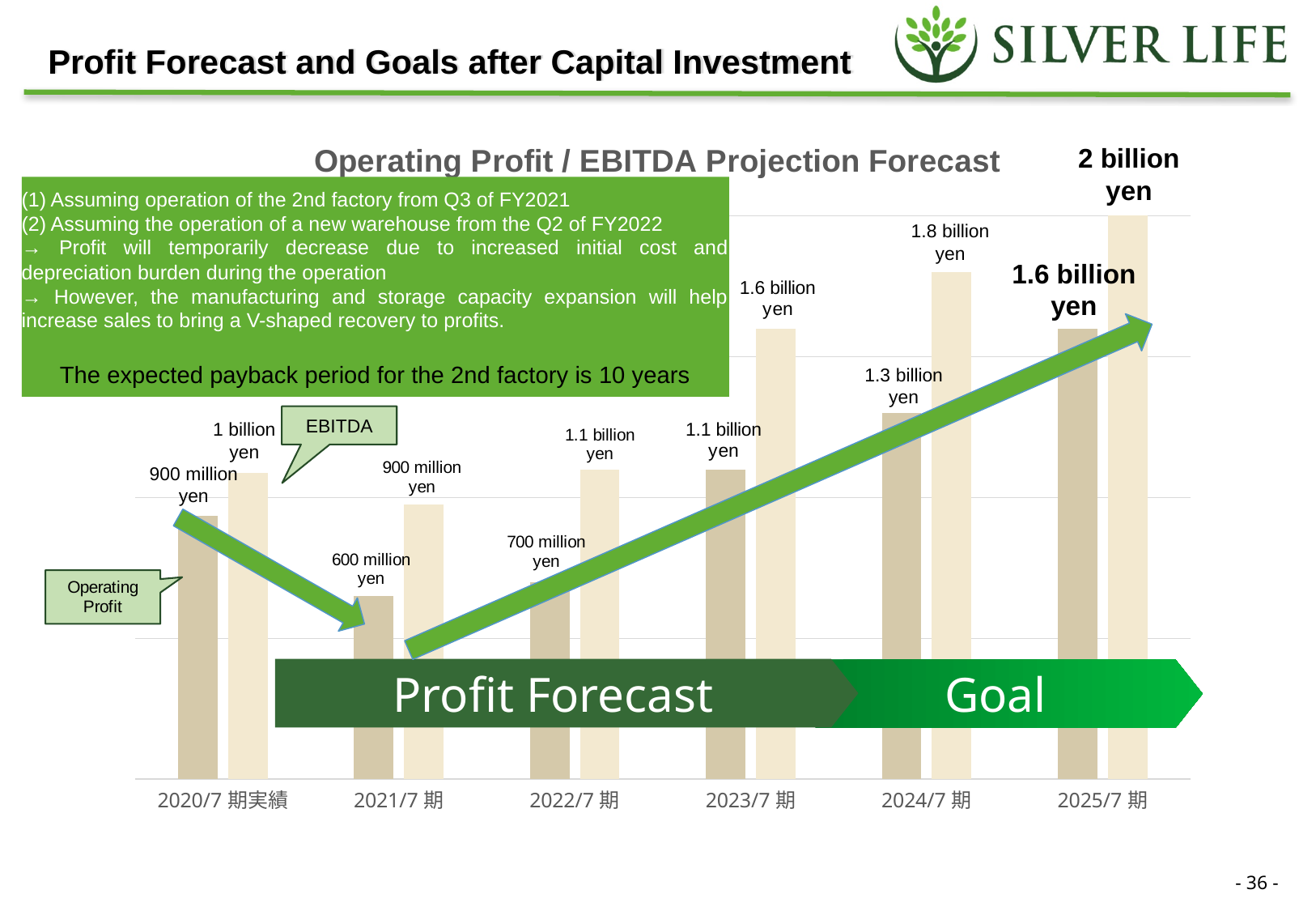
What is the EBITDA value for 2025/7 期? 2 billion yen Which is larger in 2023/7 期, Operating Profit or EBITDA? EBITDA How many series does the chart show? 2 What is the difference between EBITDA and Operating Profit in 2025/7 期? 400 million yen Which period has the lowest Operating Profit? 2021/7 期 What is the title of the chart? Operating Profit / EBITDA Projection Forecast What is the EBITDA value for 2024/7 期? 1.8 billion yen What is the Operating Profit value for 2020/7 期実績? 900 million yen What kind of chart is this? Bar chart How many periods are shown on the x axis? 6 What is the Operating Profit value for 2021/7 期? 600 million yen Which period has the highest EBITDA? 2025/7 期